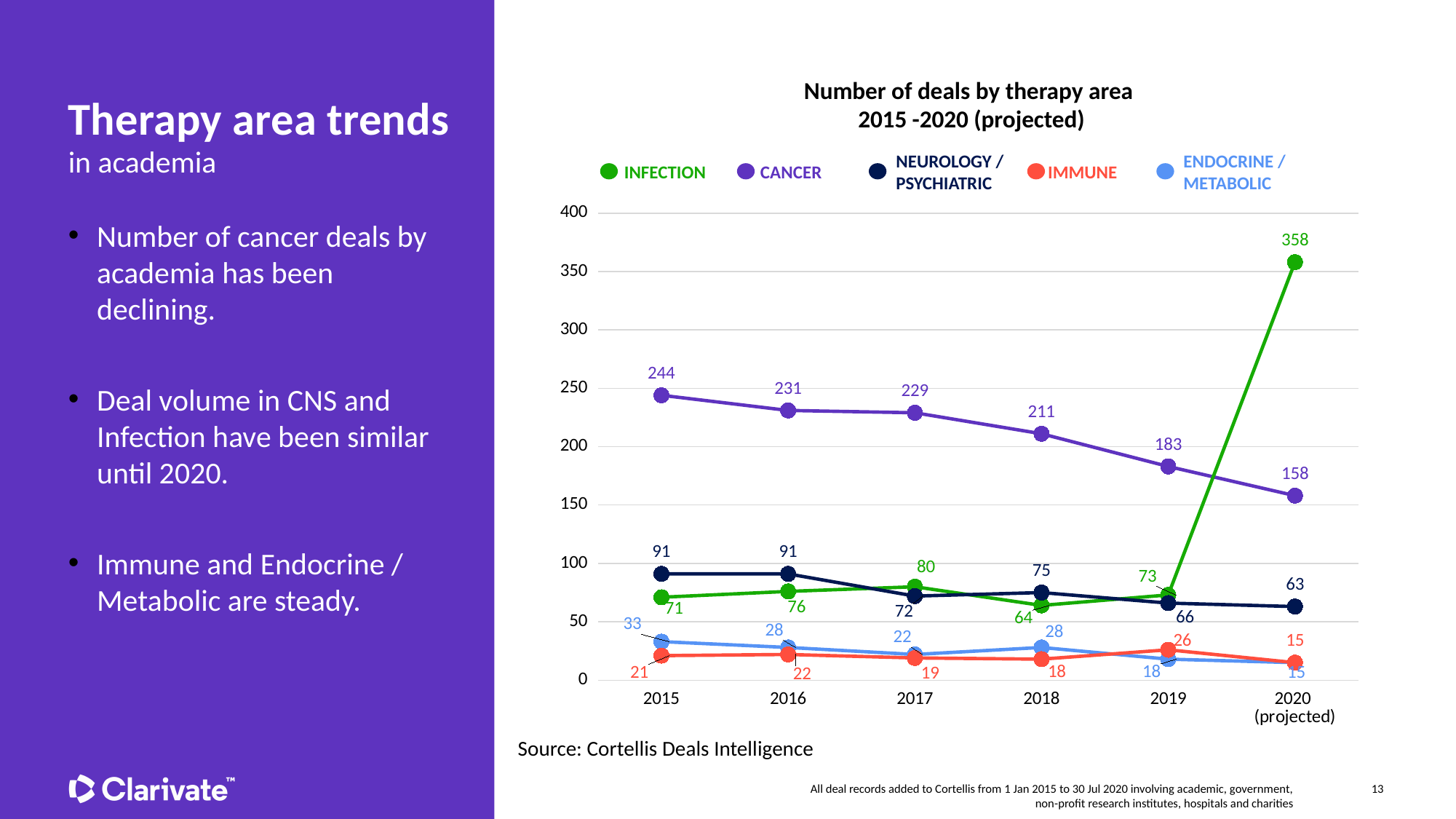
Which is larger in 2017: infection deals or neurology / psychiatric deals? Infection What is the number of immune deals in 2019? 26 Which therapy area has the lowest number of deals in 2015? Immune What type of chart is shown? Line chart How many years are shown on the x axis? 6 What is the difference between cancer deals in 2015 and cancer deals in 2020 (projected)? 86 Do cancer deals rise or fall from 2015 to 2020 (projected)? Fall How many series does the legend list? 5 What is the projected number of infection deals in 2020? 358 What is the number of neurology / psychiatric deals in 2018? 75 What is the number of cancer deals in 2015? 244 Which therapy area has the highest number of deals in 2020 (projected)? Infection